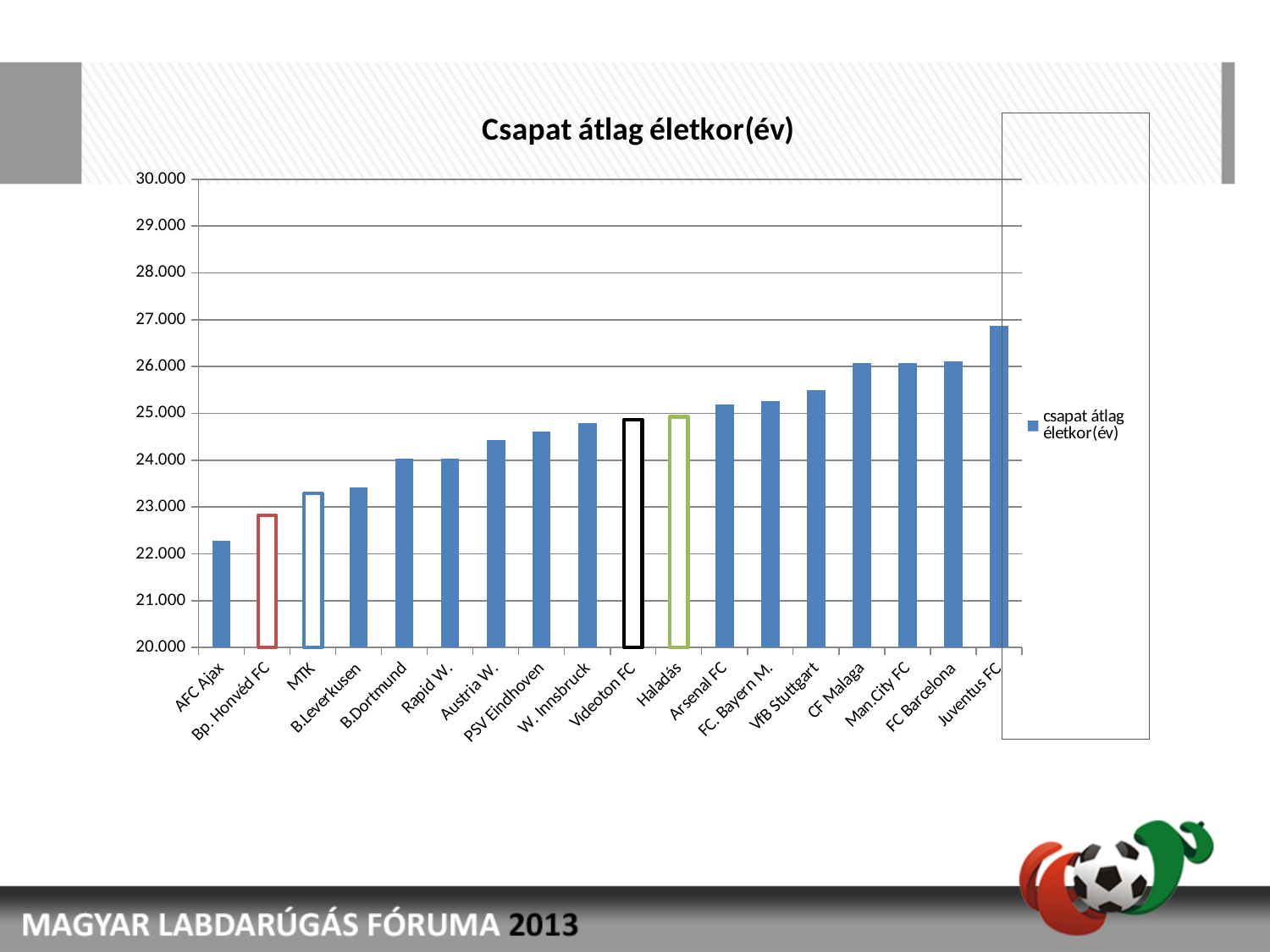
Which is larger, the value for Arsenal FC or the value for MTK? Arsenal FC How many teams (categories) are plotted on the x axis? 18 Do the values rise or fall from left to right along the x axis? rise Is the value for AFC Ajax greater or less than 23.000? less Which team has the highest bar? Juventus FC What kind of chart is shown on the slide? bar chart Is the value for VfB Stuttgart greater or less than 25.000? greater Which team has the lowest bar? AFC Ajax Is the value for Juventus FC greater or less than 26.000? greater What is the title of the chart? Csapat átlag életkor(év) How many series does the legend list? 1